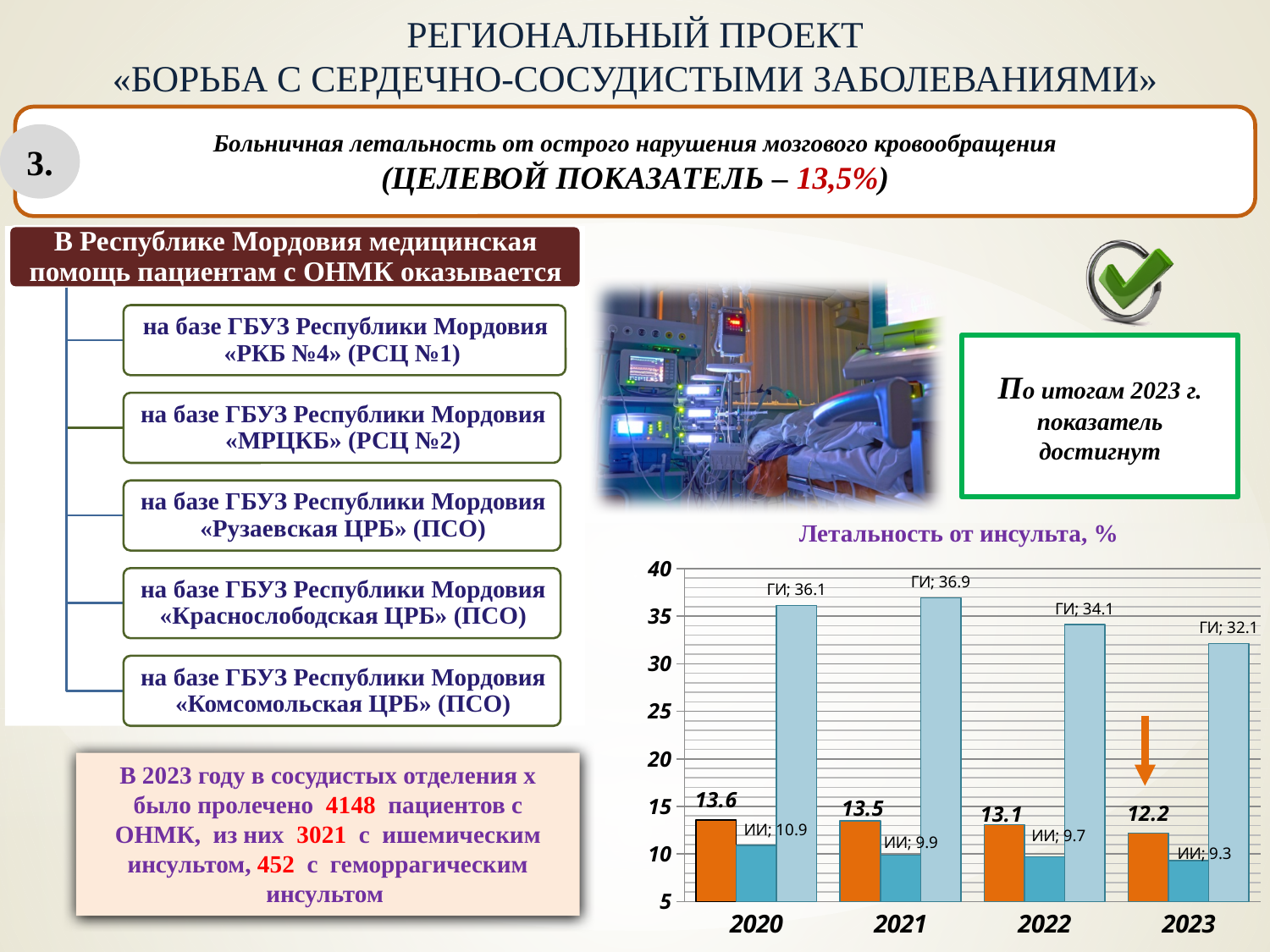
Which is larger: the ИИ value for 2020 or the ИИ value for 2022? 2020 What is the ГИ value for 2021 in the chart? 36.9 Is the ГИ value for 2023 greater or less than 30? greater How many years are shown on the x axis of the chart? 4 What type of chart is shown under the title "Летальность от инсульта, %"? bar chart Do the orange bar values rise or fall from 2020 to 2023? fall In which year is the ИИ value lowest in the chart? 2023 What is the title of the chart on the slide? Летальность от инсульта, % What is the difference between the ГИ values for 2021 and 2023? 4.8 What is the ИИ value for 2023 in the chart? 9.3 What is the value of the orange bar for 2020 in the chart? 13.6 In which year is the ГИ value highest in the chart? 2021